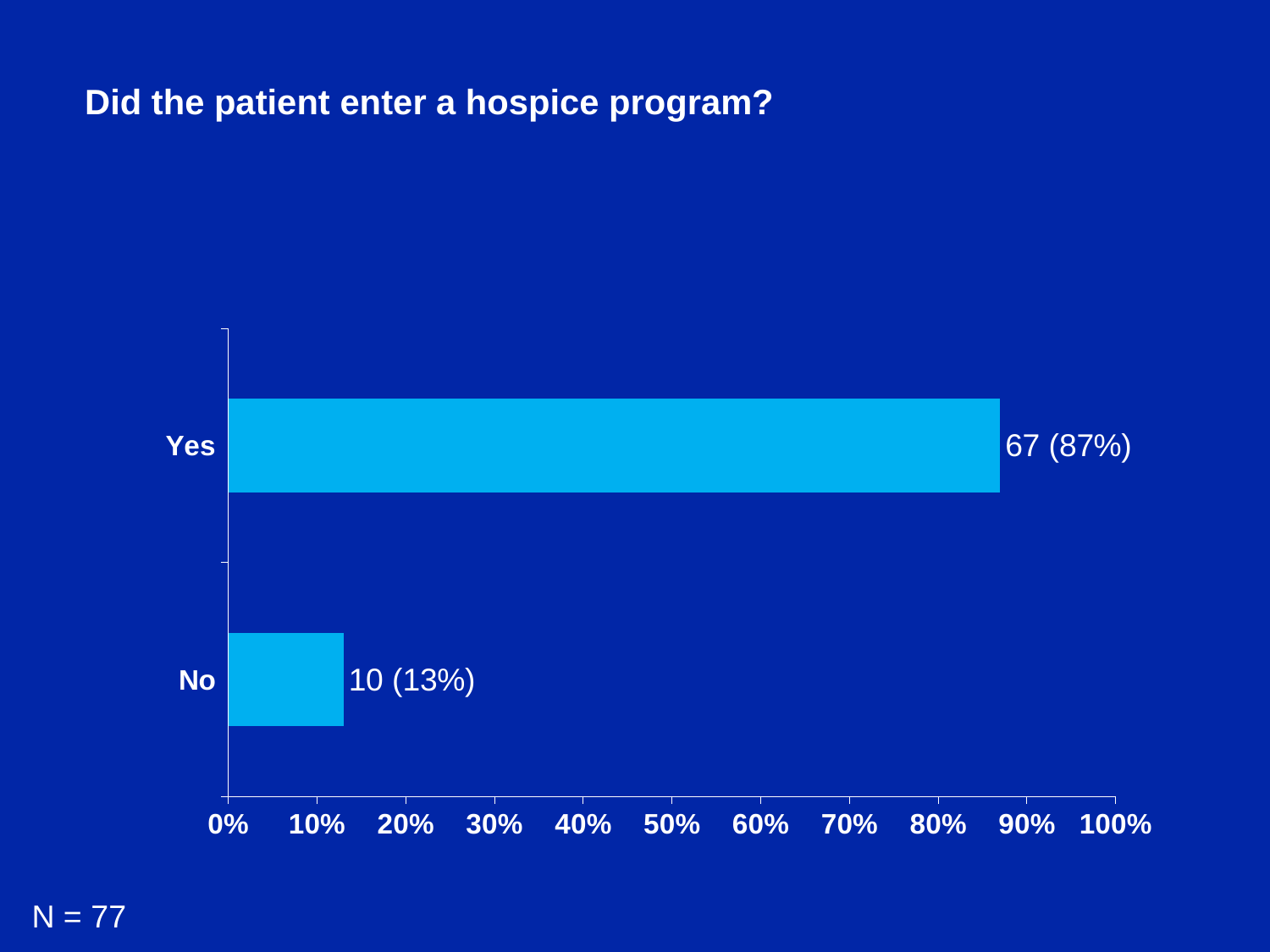
How many categories are shown on the chart? 2 What is the difference in percentage points between "Yes" and "No"? 74 What is the difference in patient counts between "Yes" and "No"? 57 What is the data label shown for the "No" bar? 10 (13%) What kind of chart is shown on the slide? bar chart How many patients did not enter a hospice program ("No")? 10 What percentage of patients entered a hospice program ("Yes")? 87% Which category has the lowest value? No Which is larger, the value for "Yes" or the value for "No"? Yes What is the data label shown for the "Yes" bar? 67 (87%) Which category has the highest value? Yes Is the value for "No" greater or less than 20%? less